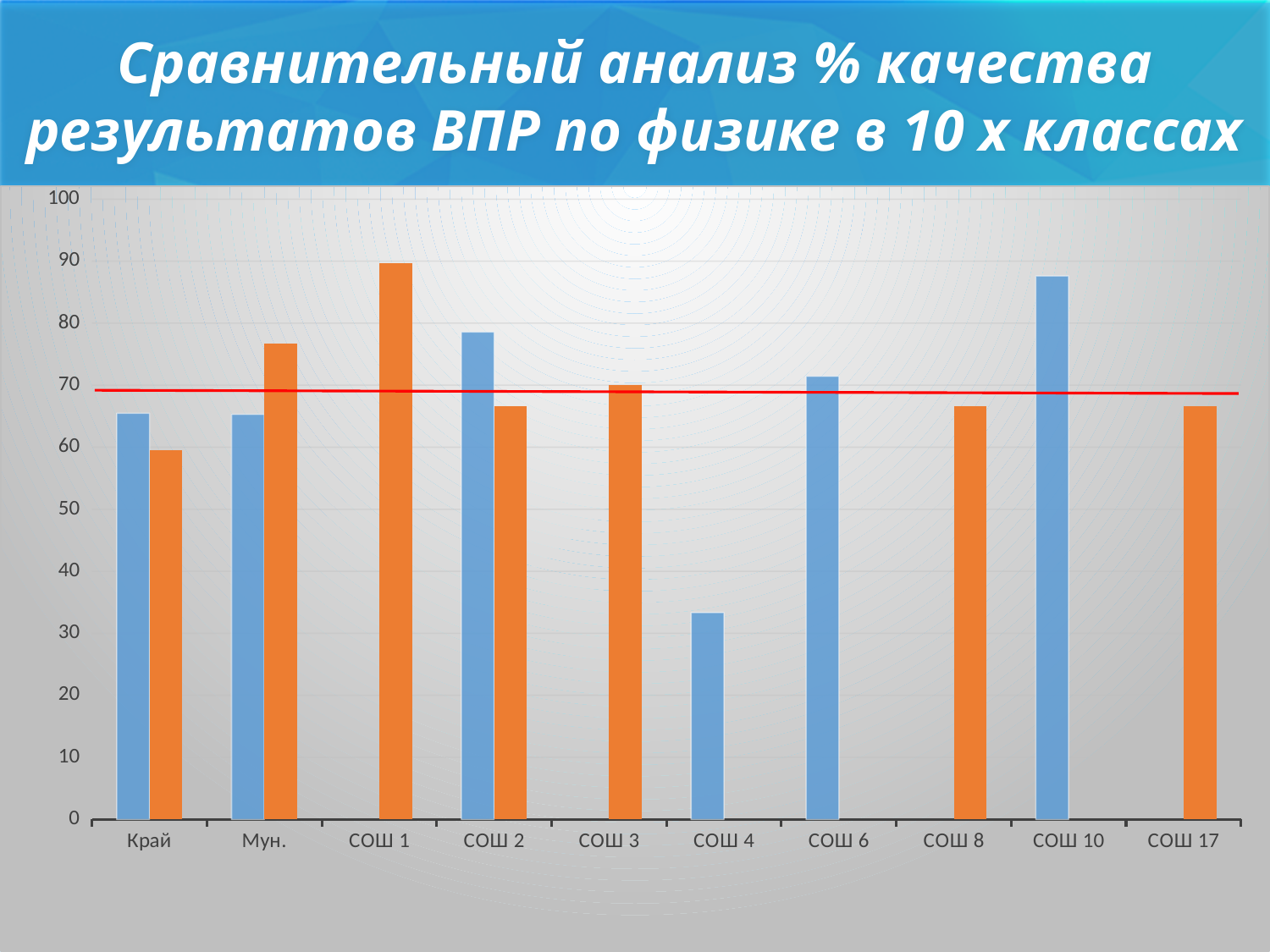
Is the orange bar for СОШ 8 greater or less than 70? less How many categories are shown along the x axis? 10 Which is larger, the blue bar for СОШ 4 or the blue bar for СОШ 6? СОШ 6 What kind of chart is shown on the slide? bar chart What is the title of the slide containing the chart? Сравнительный анализ % качества результатов ВПР по физике в 10 х классах Which category has the lowest blue bar? СОШ 4 Which category has the highest orange bar? СОШ 1 Is the orange bar for СОШ 1 greater or less than 80? greater Is the blue bar for СОШ 2 greater or less than 70? greater